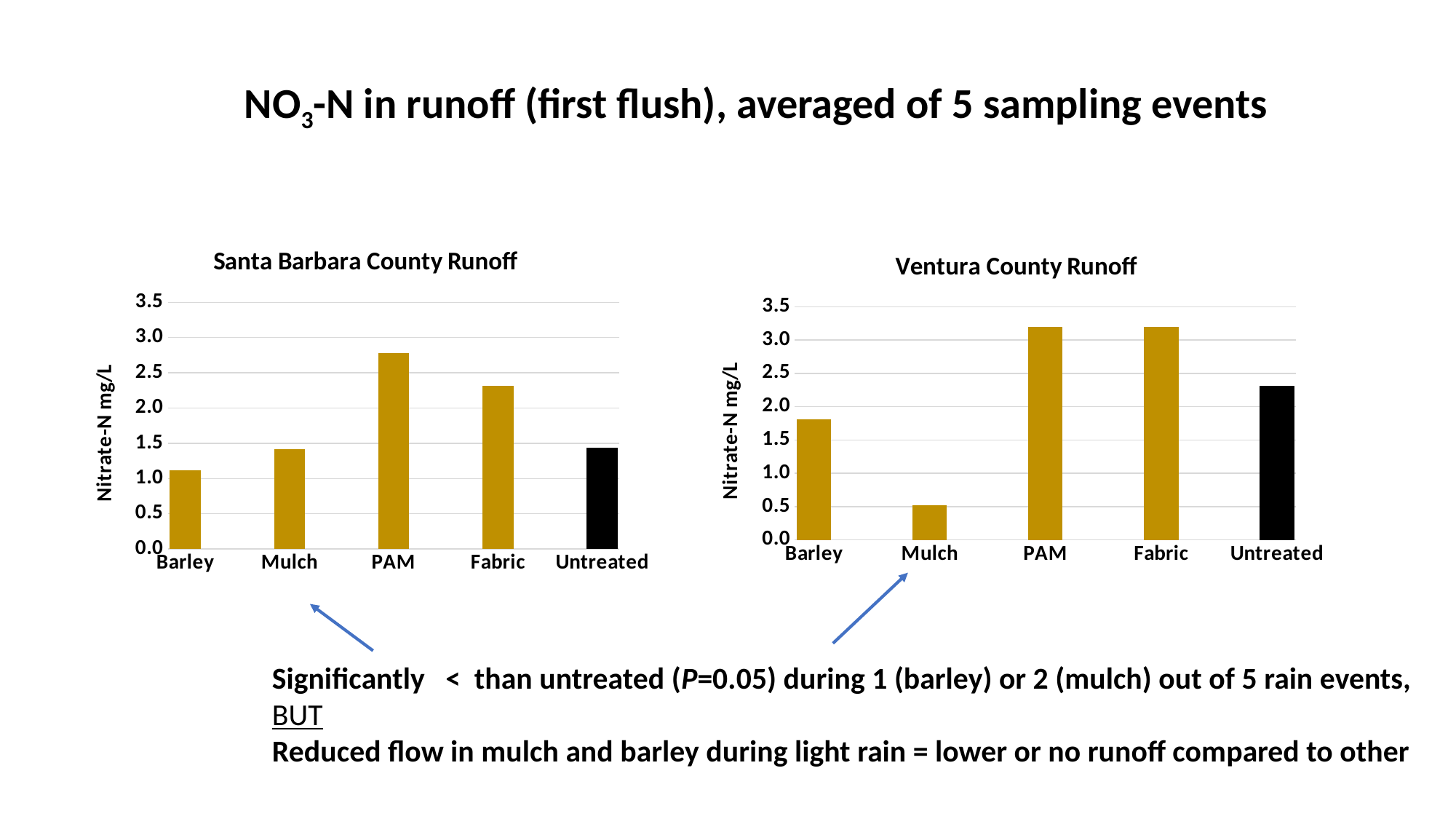
In the Ventura County Runoff chart, is the value for Mulch greater or less than 1.0? less In the Santa Barbara County Runoff chart, is the value for Barley greater or less than 1.5? less In the Ventura County Runoff chart, is the value for Fabric greater or less than 3.0? greater In the Santa Barbara County Runoff chart, which is larger, the value for Fabric or the value for Mulch? Fabric How many treatment categories are shown in the Ventura County Runoff chart? 5 In the Ventura County Runoff chart, which is larger, the value for Barley or the value for Untreated? Untreated In the Santa Barbara County Runoff chart, which treatment has the lowest nitrate-N value? Barley In the Ventura County Runoff chart, which treatment has the lowest nitrate-N value? Mulch What kind of chart is the Santa Barbara County Runoff chart? bar chart What is the y-axis label of the Santa Barbara County Runoff chart? Nitrate-N mg/L In the Santa Barbara County Runoff chart, which treatment has the highest nitrate-N value? PAM